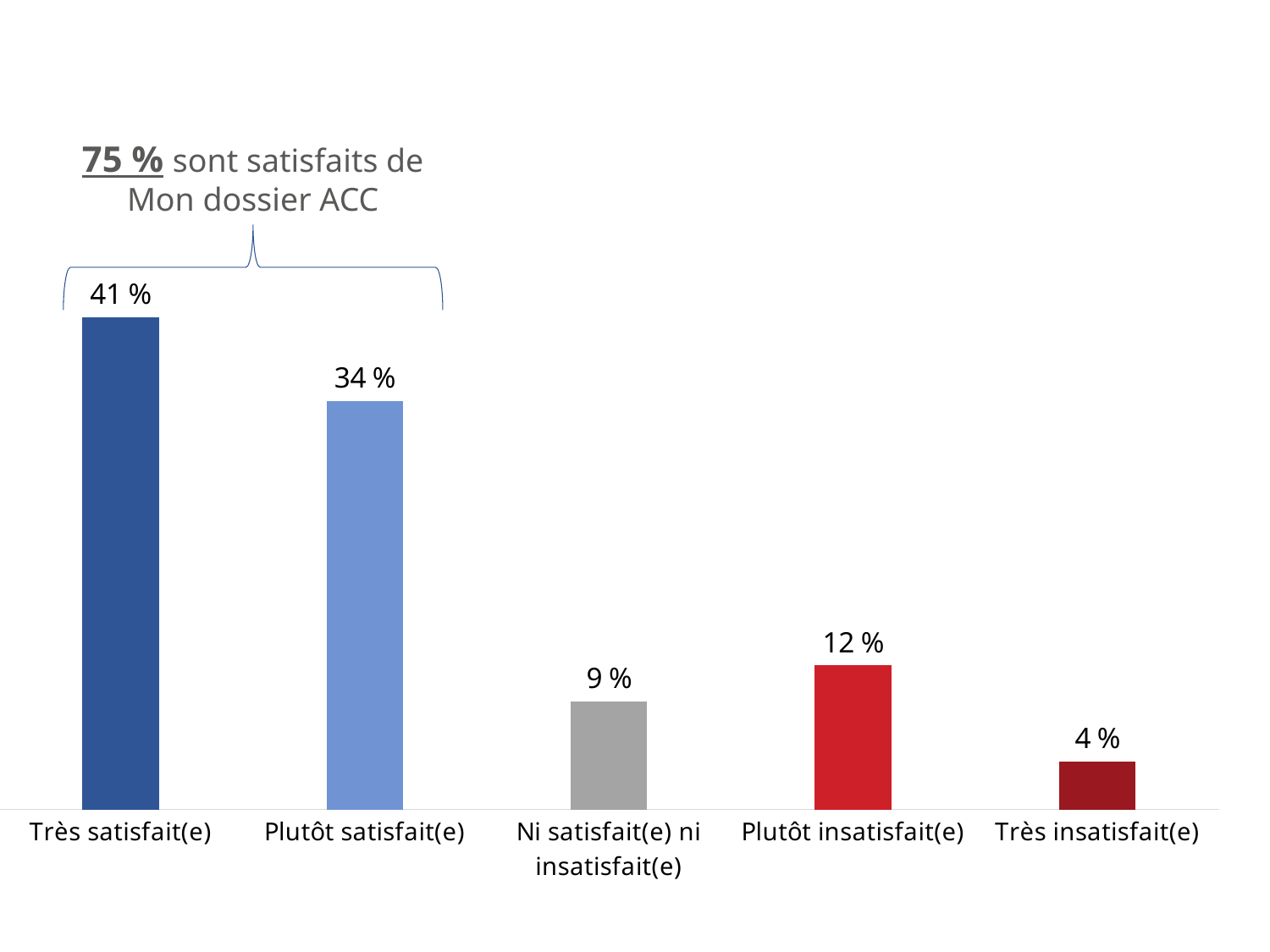
What is the value for Plutôt insatisfait(e)? 12 % Which category has the highest value? Très satisfait(e) What is the value for Très satisfait(e)? 41 % What is the value for Plutôt satisfait(e)? 34 % What is the difference between the values for Très satisfait(e) and Plutôt satisfait(e)? 7 % How many categories are shown on the x axis? 5 Which is larger, the value for Plutôt insatisfait(e) or the value for Ni satisfait(e) ni insatisfait(e)? Plutôt insatisfait(e) What is the value for Très insatisfait(e)? 4 % What is the value for Ni satisfait(e) ni insatisfait(e)? 9 % Which category has the lowest value? Très insatisfait(e) What kind of chart is shown on the slide? Bar chart According to the annotation above the chart, what percentage are satisfied with Mon dossier ACC? 75 %